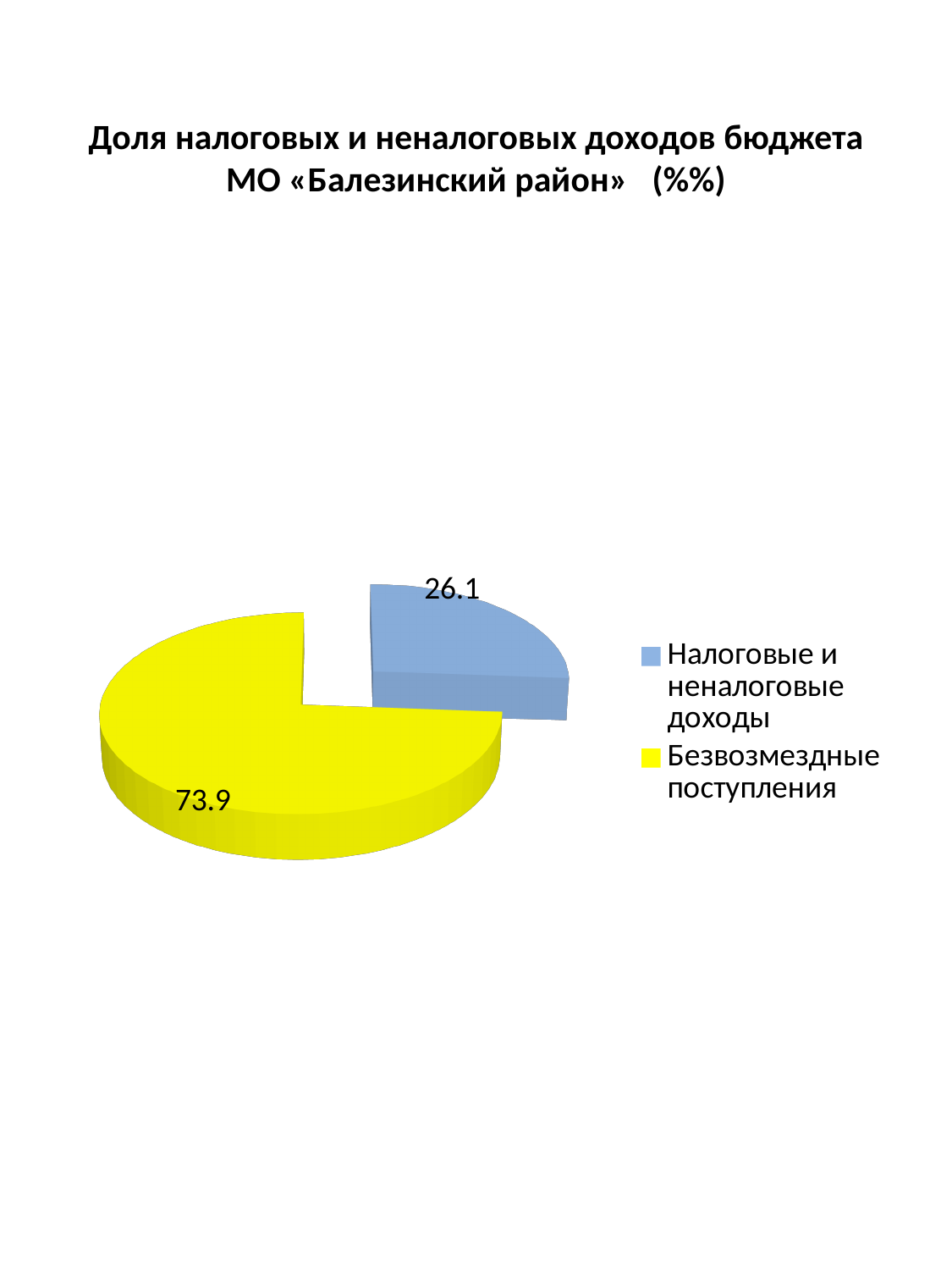
What is the difference between the values for Безвозмездные поступления and Налоговые и неналоговые доходы? 47.8 What is the total of the two values shown on the pie chart? 100 Which is larger: Налоговые и неналоговые доходы or Безвозмездные поступления? Безвозмездные поступления What value is shown for Налоговые и неналоговые доходы? 26.1 What kind of chart is shown on the slide? Pie chart What colour is the slice for Налоговые и неналоговые доходы? Blue How many slices does the pie chart have? 2 How many entries does the legend list? 2 Which category has the largest slice of the pie? Безвозмездные поступления What colour is the slice for Безвозмездные поступления? Yellow What value is shown for Безвозмездные поступления? 73.9 Which category has the smallest slice of the pie? Налоговые и неналоговые доходы